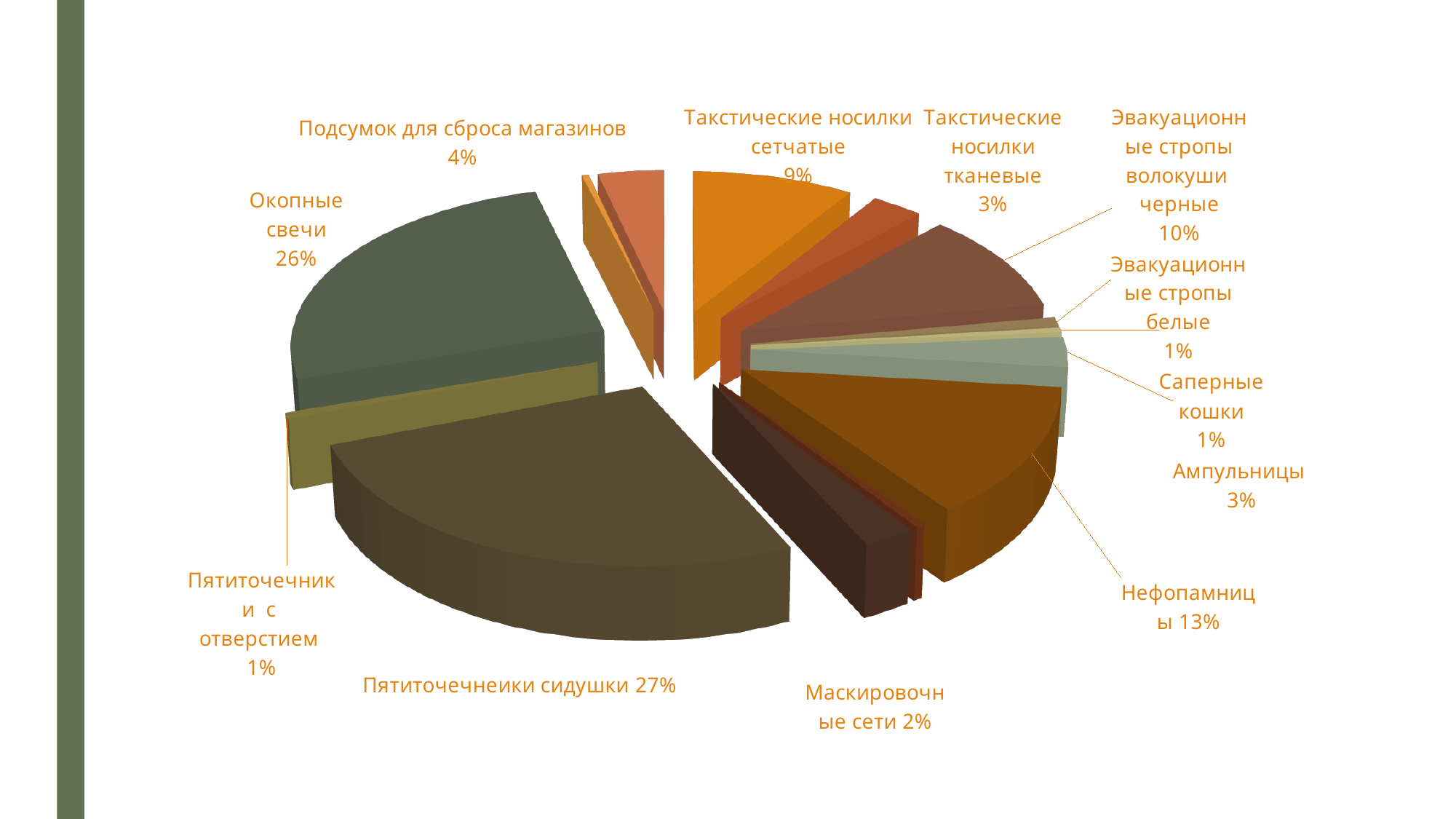
What percentage is shown for Нефопамницы? 13% What percentage is shown for Эвакуационные стропы волокуши черные? 10% What is the difference in percentage points between Нефопамницы and Ампульницы? 10 How many categories are labelled with 1%? 3 What kind of chart is shown on the slide? Pie chart Which is larger: the share for Пятиточечнеики сидушки or for Окопные свечи? Пятиточечнеики сидушки What percentage is shown for Маскировочные сети? 2% What percentage is shown for Такстические носилки сетчатые? 9% What share of the pie is labelled for Окопные свечи? 26% Which category has the largest share of the pie? Пятиточечнеики сидушки (27%) What is the difference in percentage points between Такстические носилки сетчатые and Такстические носилки тканевые? 6